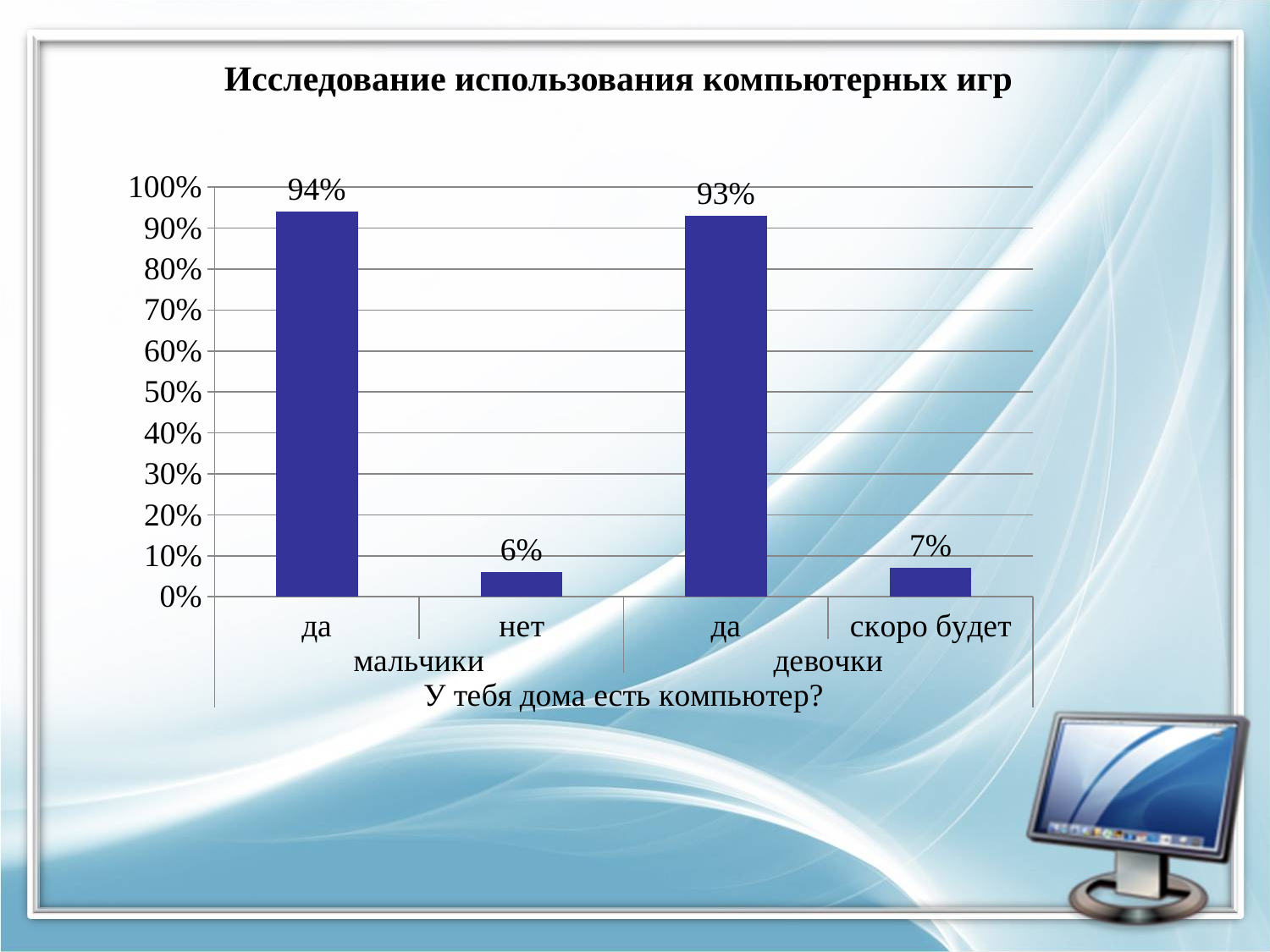
What is the difference between the boys' "да" value and the girls' "да" value? 1% What percentage of boys (мальчики) answered "нет"? 6% What is the difference between the boys' "да" and "нет" values? 88% Which is larger: the boys' "нет" value or the girls' "скоро будет" value? скоро будет (девочки) What percentage of girls (девочки) answered "скоро будет"? 7% What percentage of girls (девочки) answered "да"? 93% What percentage of boys (мальчики) answered "да" to having a computer at home? 94% Which bar has the highest value on the chart? да (мальчики) How many bars are plotted on the chart? 4 What question is written as the x-axis title of the chart? У тебя дома есть компьютер? What type of chart is shown on the slide? bar chart Which bar has the lowest value on the chart? нет (мальчики)